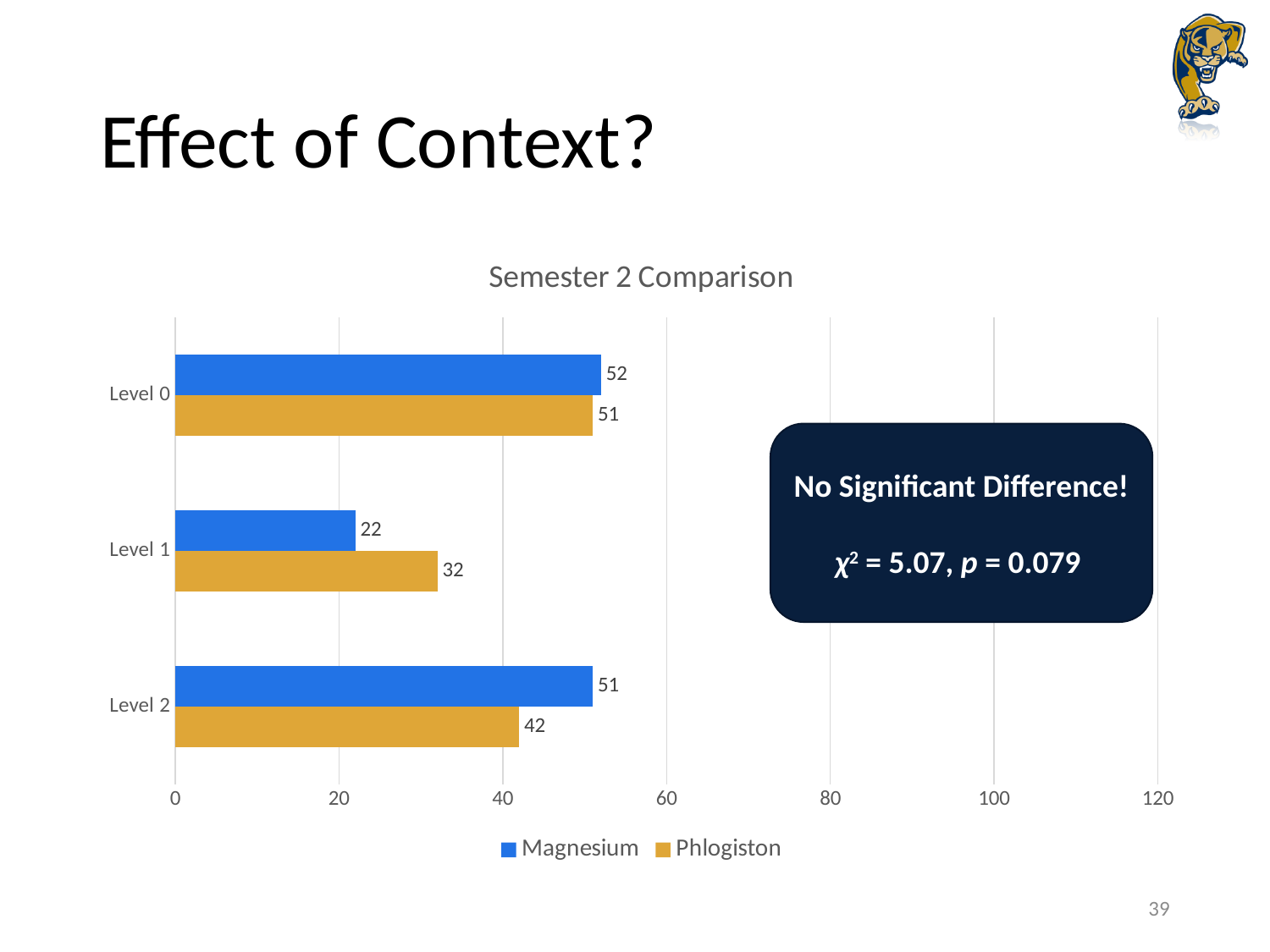
What is the Magnesium value for Level 0? 52 Which level has the lowest Magnesium value? Level 1 What is the difference between the Magnesium and Phlogiston values for Level 2? 9 What is the title of the chart? Semester 2 Comparison How many series does the legend list? 2 What is the difference between the Phlogiston and Magnesium values for Level 1? 10 What is the Phlogiston value for Level 2? 42 Which level has the highest Phlogiston value? Level 0 For Level 1, which series has the larger value, Magnesium or Phlogiston? Phlogiston What kind of chart is shown on the slide? Bar chart How many levels are shown on the chart? 3 What is the Phlogiston value for Level 1? 32